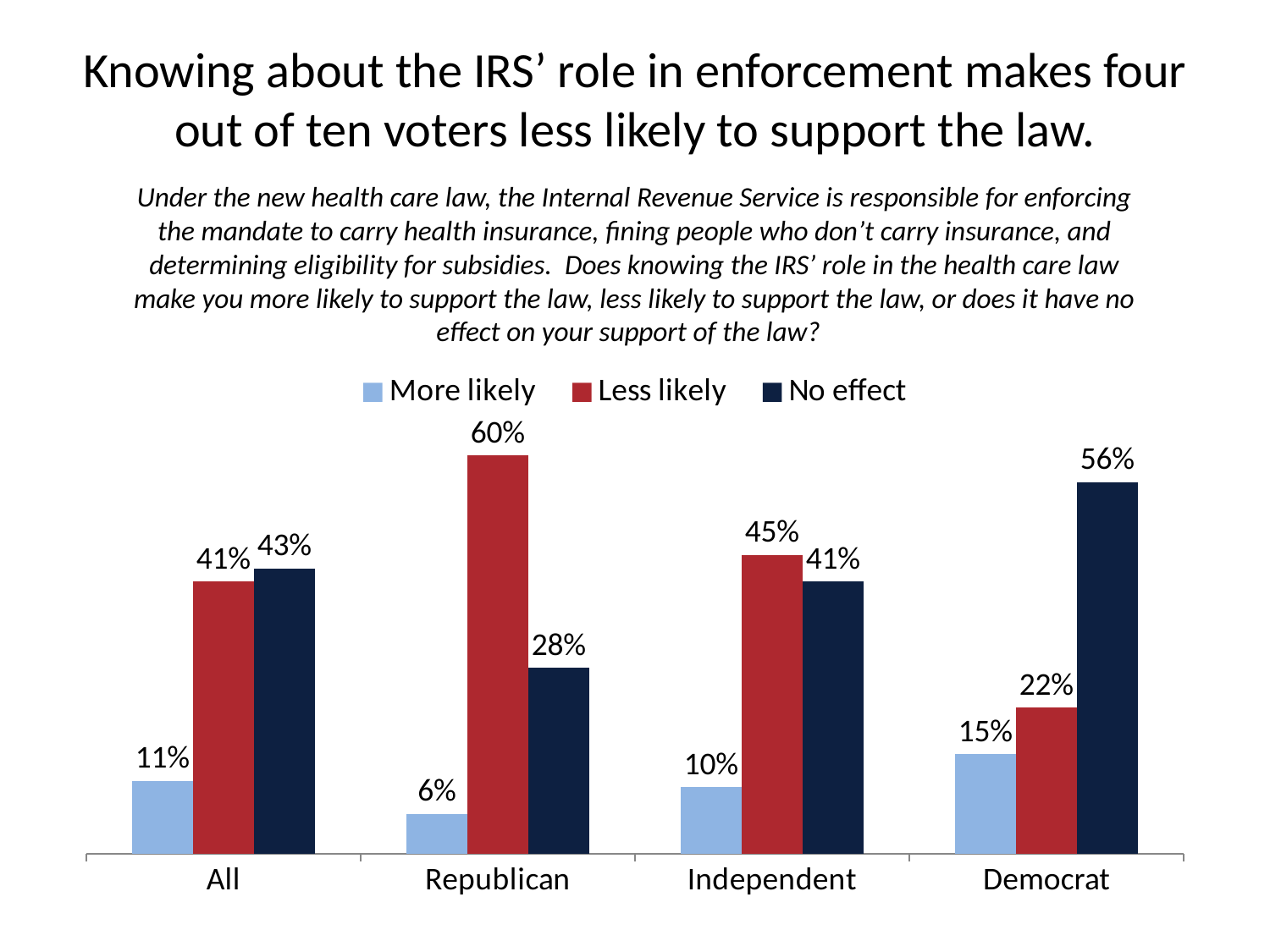
How many groups are shown on the x axis? 4 Which group has the lowest 'More likely' value? Republican What is the 'No effect' value for Democrats? 56% For Independents, which is larger: 'Less likely' or 'No effect'? Less likely Which colour represents the 'Less likely' series? Red How many series does the legend list? 3 What percentage of Republicans say knowing the IRS' role makes them less likely to support the law? 60% What is the 'More likely' value for All voters? 11% What kind of chart is shown on the slide? Bar chart Which group has the highest 'Less likely' value? Republican What is the difference between the 'Less likely' values for Republicans and Democrats? 38% What is the difference between the 'No effect' values for Democrats and Republicans? 28%